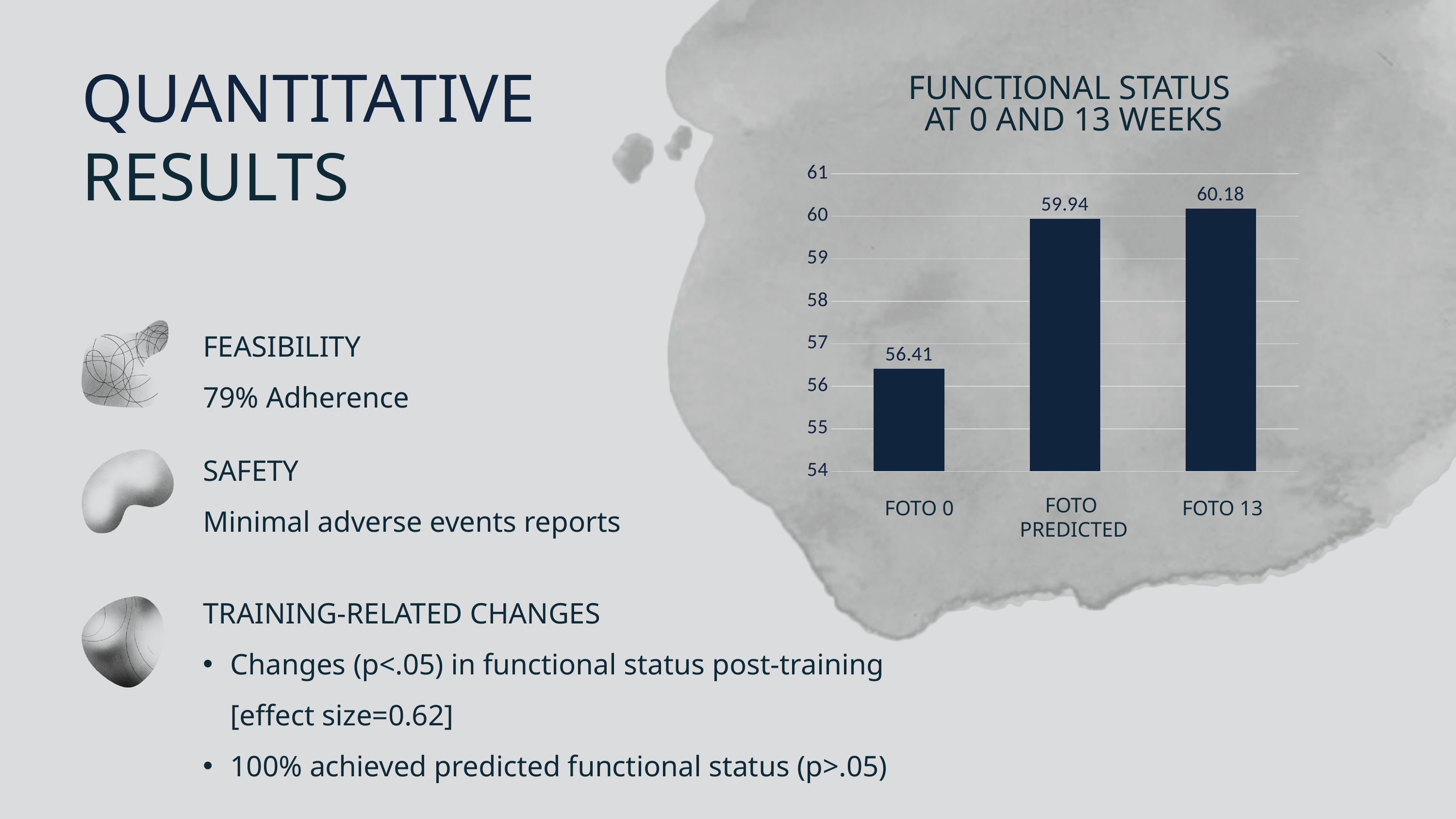
How many categories are shown on the chart? 3 What is the difference between the values for FOTO 13 and FOTO 0? 3.77 What is the value for FOTO 0? 56.41 What is the difference between the values for FOTO PREDICTED and FOTO 0? 3.53 Which category has the highest value? FOTO 13 What kind of chart is shown on the slide? bar chart What is the value for FOTO 13? 60.18 Which is larger, the value for FOTO 0 or the value for FOTO PREDICTED? FOTO PREDICTED What is the title of the chart? FUNCTIONAL STATUS AT 0 AND 13 WEEKS Is the value for FOTO 0 greater or less than 57? less What is the value for FOTO PREDICTED? 59.94 Which category has the lowest value? FOTO 0